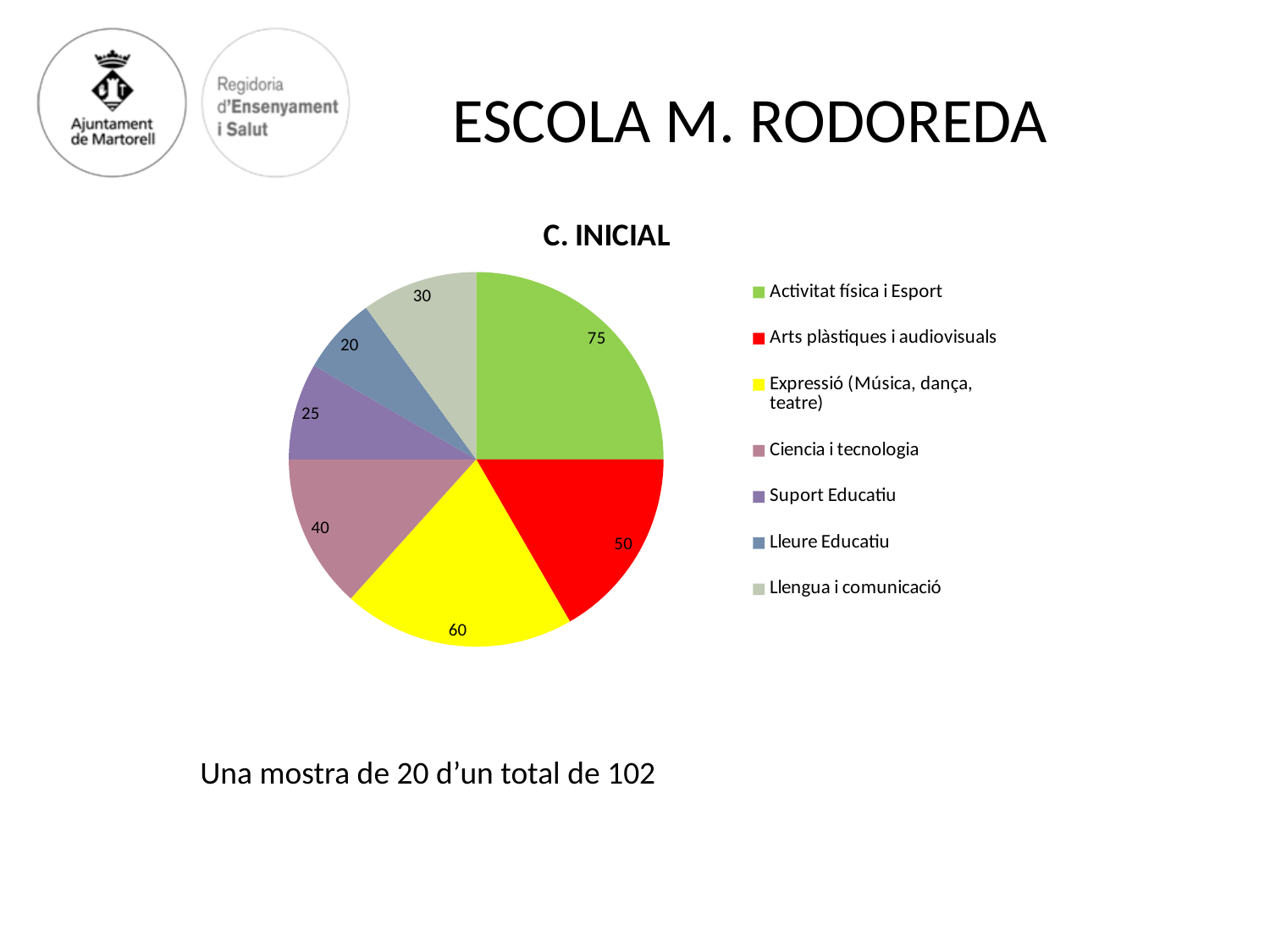
Which is larger in the C. INICIAL pie chart, Ciencia i tecnologia or Llengua i comunicació? Ciencia i tecnologia What share of the C. INICIAL pie does Llengua i comunicació represent? 10% What is the value for Lleure Educatiu in the C. INICIAL pie chart? 20 Which category has the smallest slice in the C. INICIAL pie chart? Lleure Educatiu What is the value for Expressió (Música, dança, teatre) in the C. INICIAL pie chart? 60 What share of the C. INICIAL pie does Activitat física i Esport represent? 25% What colour is the Expressió (Música, dança, teatre) slice in the C. INICIAL pie chart? Yellow Which category has the largest slice in the C. INICIAL pie chart? Activitat física i Esport How many categories are shown in the C. INICIAL pie chart? 7 What is the value for Activitat física i Esport in the C. INICIAL pie chart? 75 What kind of chart is shown on the slide? Pie chart What is the difference between the values for Activitat física i Esport and Arts plàstiques i audiovisuals in the C. INICIAL pie chart? 25